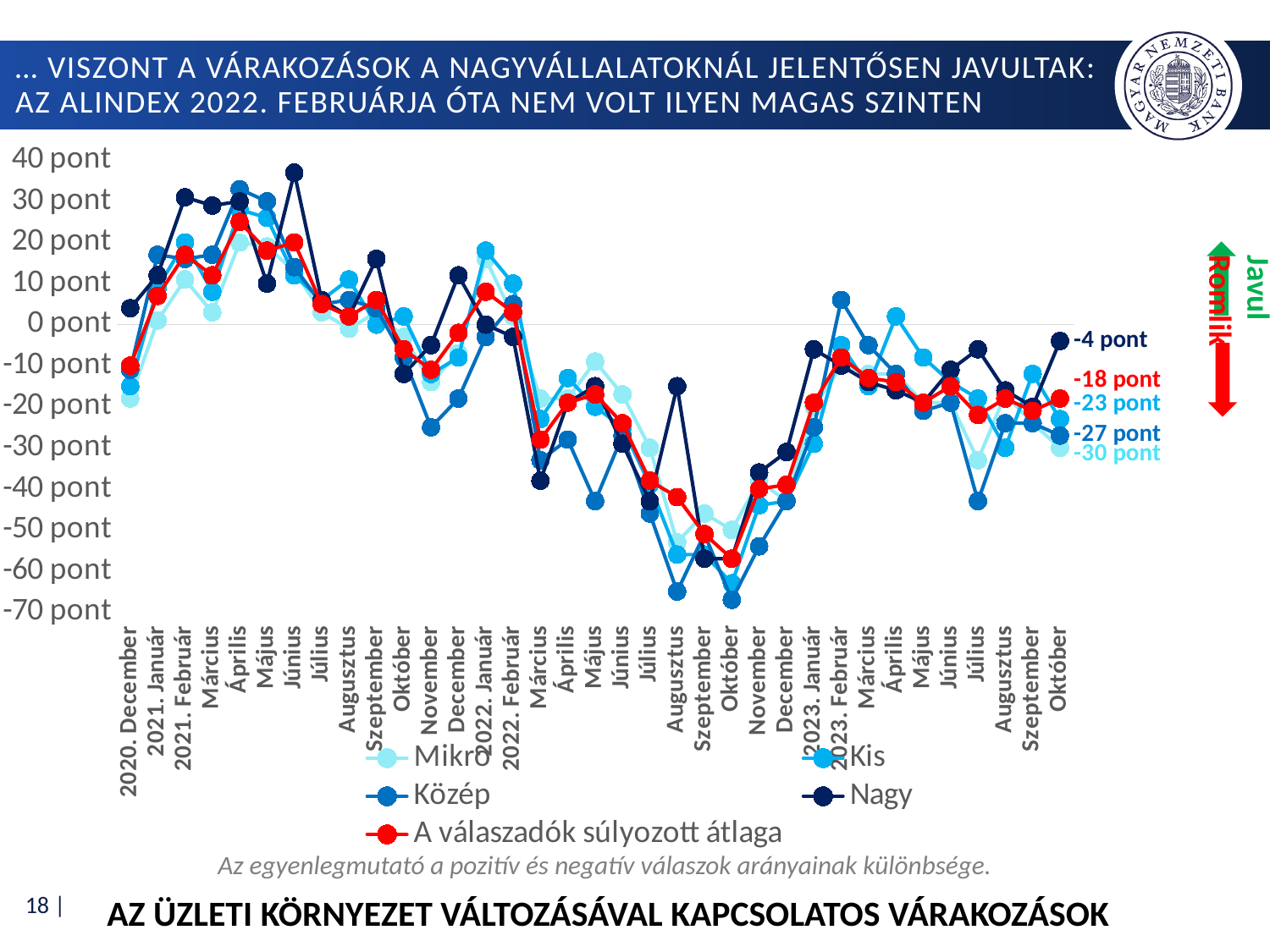
What is the value for A válaszadók súlyozott átlaga in 2023. Október? -18 pont What is the difference between the Nagy value and the Mikro value in 2023. Október? 26 pont What is the value for the Nagy series in 2023. Október? -4 pont How many series does the legend list? 5 What is the value for the Közép series in 2023. Október? -27 pont What is the value for the Mikro series in 2023. Október? -30 pont Which series has the lowest value in 2023. Október? Mikro Is the value for the Közép series in 2022. Október greater or less than -60 pont? less What type of chart is shown on the slide? line chart Which series has the highest value in 2023. Október? Nagy Is the value for the Nagy series in 2021. Június greater or less than 30 pont? greater What is the value for the Kis series in 2023. Október? -23 pont